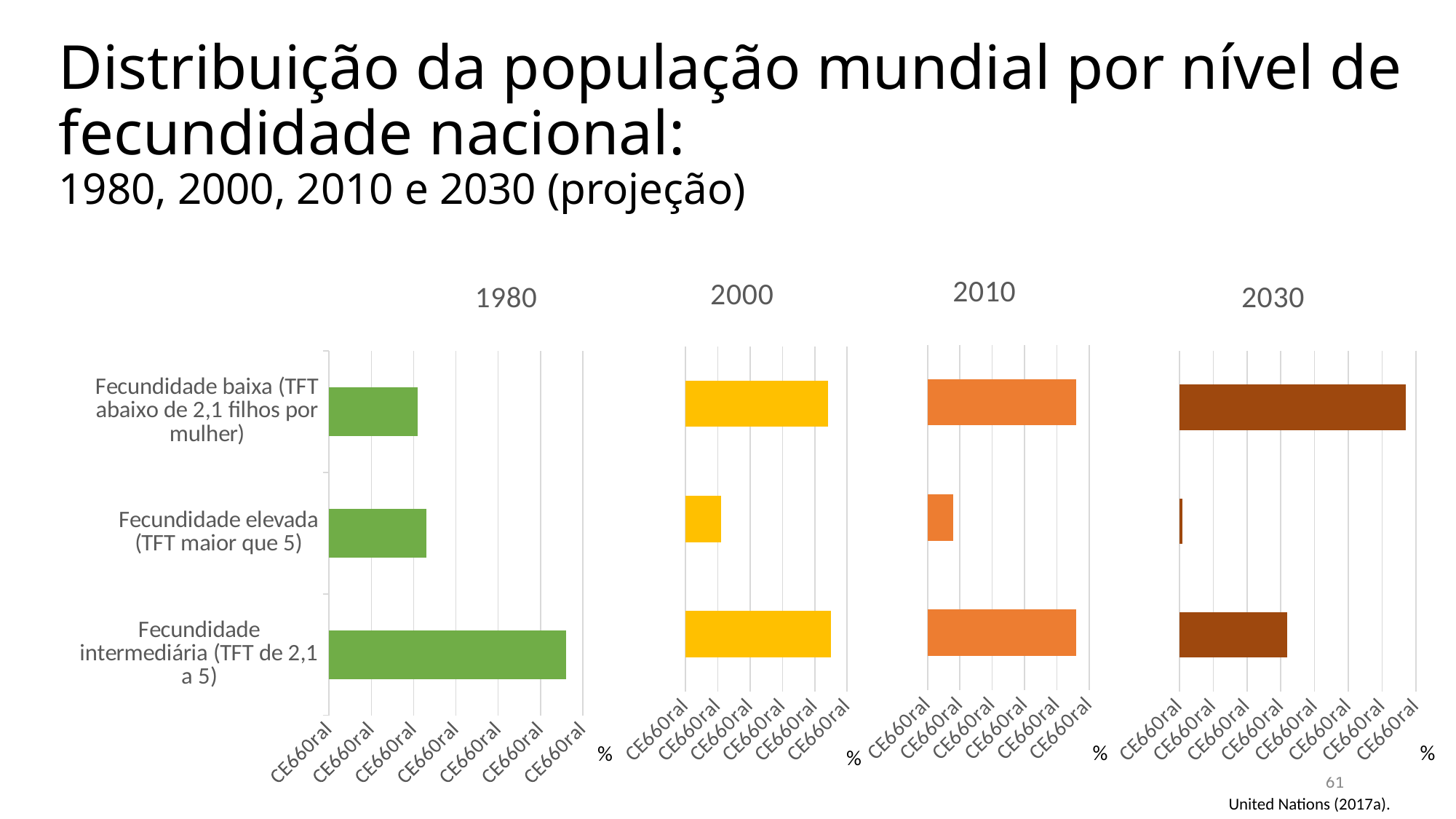
In the 2000 chart, which category has the lowest value? Fecundidade elevada (TFT maior que 5) In the 2010 chart, which category has the lowest value? Fecundidade elevada (TFT maior que 5) What colour are the bars in the 2030 chart? Brown In the 2030 chart, which category has the lowest value? Fecundidade elevada (TFT maior que 5) How many charts are shown on the slide? 4 What kind of chart is the 1980 chart? Bar chart In the 1980 chart, which is larger: Fecundidade intermediária or Fecundidade baixa? Fecundidade intermediária In the 2000 chart, which is larger: Fecundidade elevada or Fecundidade baixa? Fecundidade baixa In the 2030 chart, which is larger: Fecundidade baixa or Fecundidade intermediária? Fecundidade baixa How many categories does the 2010 chart show? 3 In the 1980 chart, which category has the highest value? Fecundidade intermediária (TFT de 2,1 a 5) In the 2030 chart, which category has the highest value? Fecundidade baixa (TFT abaixo de 2,1 filhos por mulher)